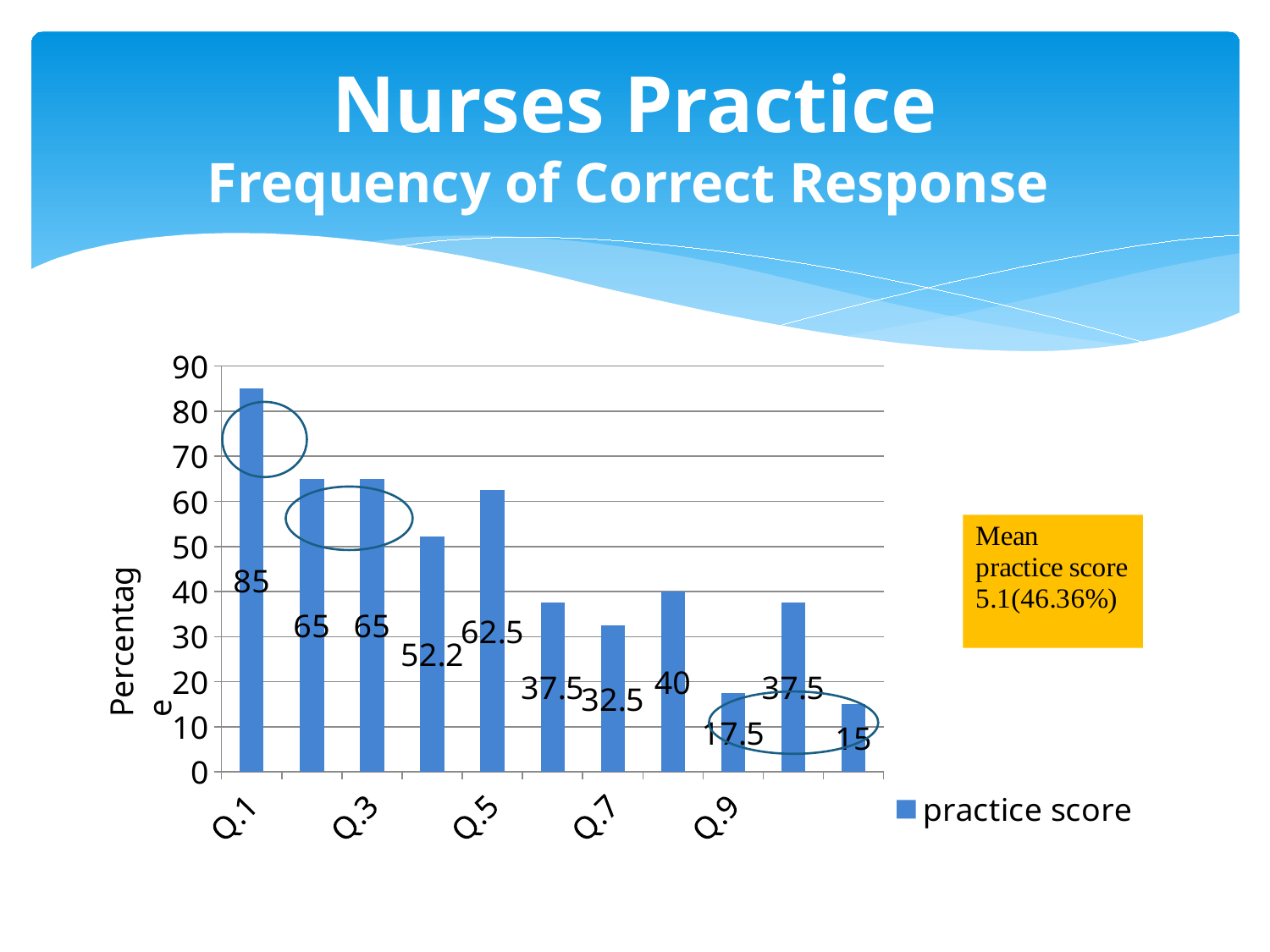
Which question has the highest practice score? Q.1 What is the practice score value for Q.3? 65 What is the practice score value for Q.1? 85 What is the practice score value for Q.5? 62.5 What is the difference between the practice score for Q.1 and Q.3? 20 Which has a larger practice score, Q.5 or Q.7? Q.5 How many bars are plotted on the chart? 11 What is the smallest value shown on the chart? 15 What kind of chart is shown on the slide? Bar chart What is the label of the series in the legend? practice score What is the practice score value for Q.9? 17.5 What is the practice score value for Q.7? 32.5